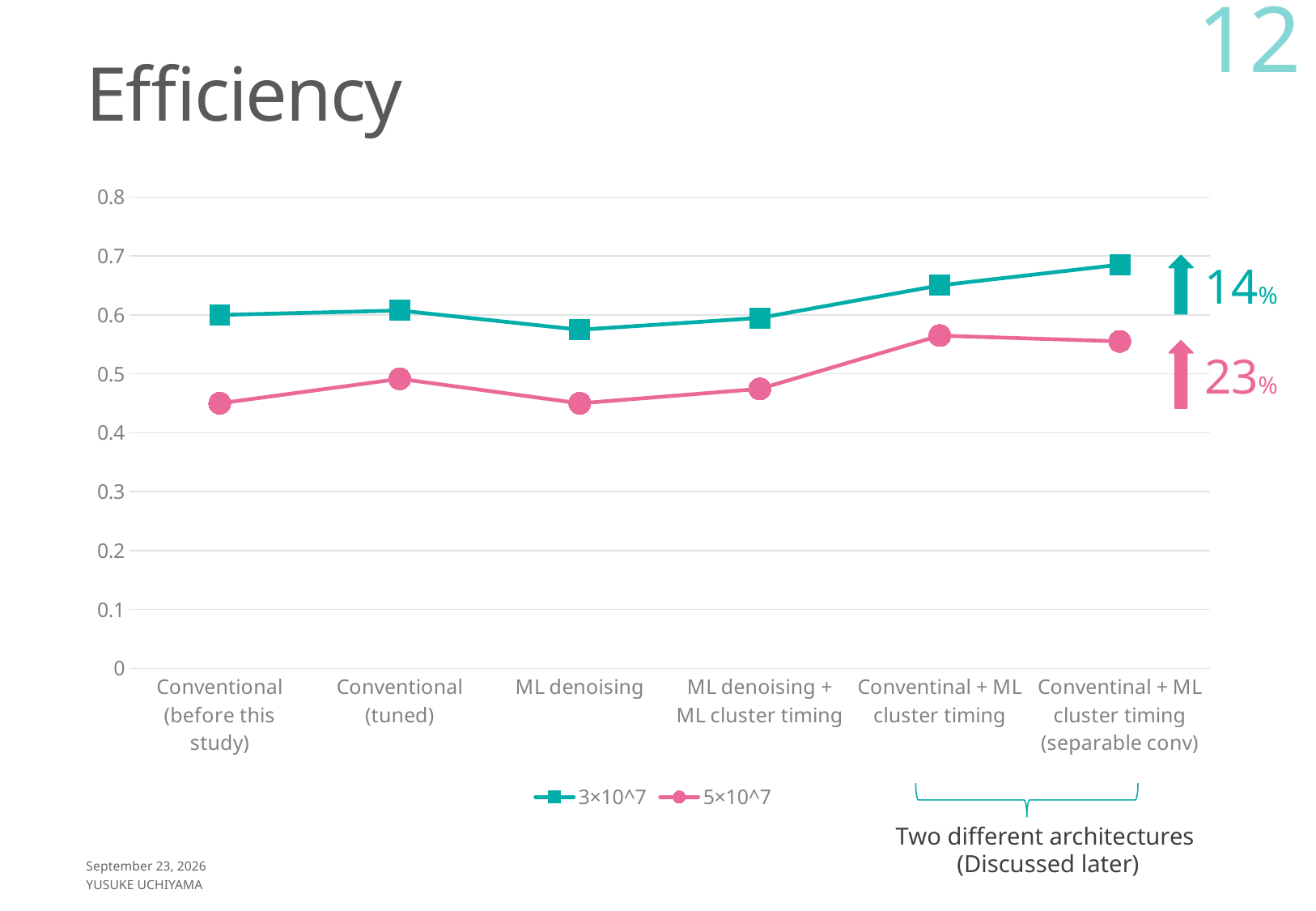
What percentage improvement is annotated next to the 3×10^7 series at the right of the chart? 14% Is the 5×10^7 value for Conventional + ML cluster timing greater or less than 0.5? greater For which category is the 3×10^7 series highest? Conventional + ML cluster timing (separable conv) Is the 3×10^7 value for Conventional (before this study) greater or less than 0.5? greater Is the 5×10^7 value for ML denoising greater or less than 0.5? less Does the 5×10^7 series end higher or lower at the last category than it starts at the first category? higher What is the title of the chart? Efficiency How many series does the legend list? 2 Which series has the higher value for ML denoising, 3×10^7 or 5×10^7? 3×10^7 How many categories are shown on the x axis? 6 What kind of chart is shown on the slide? line chart